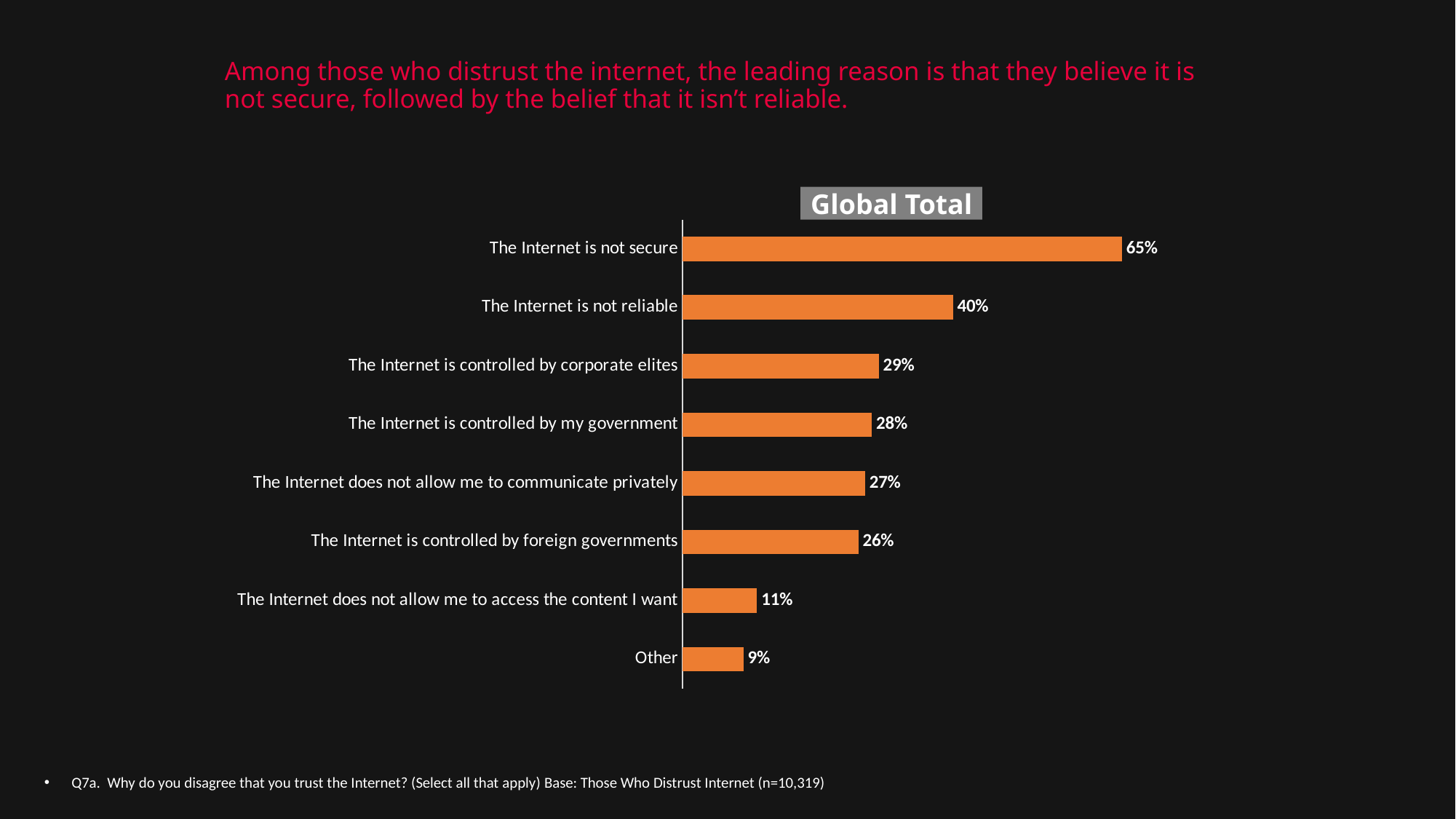
Which reason has the lowest percentage? Other How many reasons (categories) are shown in the chart? 8 Which is larger: "The Internet is not reliable" or "The Internet is controlled by foreign governments"? The Internet is not reliable What colour are the bars in the chart? Orange What kind of chart is shown on the slide? Bar chart What is the difference between "The Internet is not secure" and "The Internet is not reliable"? 25 percentage points What is the title of the chart? Global Total Which reason has the highest percentage? The Internet is not secure What is the value for "The Internet is controlled by my government"? 28% What percentage of respondents said "The Internet is not secure"? 65% What percentage is shown for "Other"? 9% What is the difference between "The Internet is controlled by corporate elites" and "The Internet does not allow me to access the content I want"? 18 percentage points